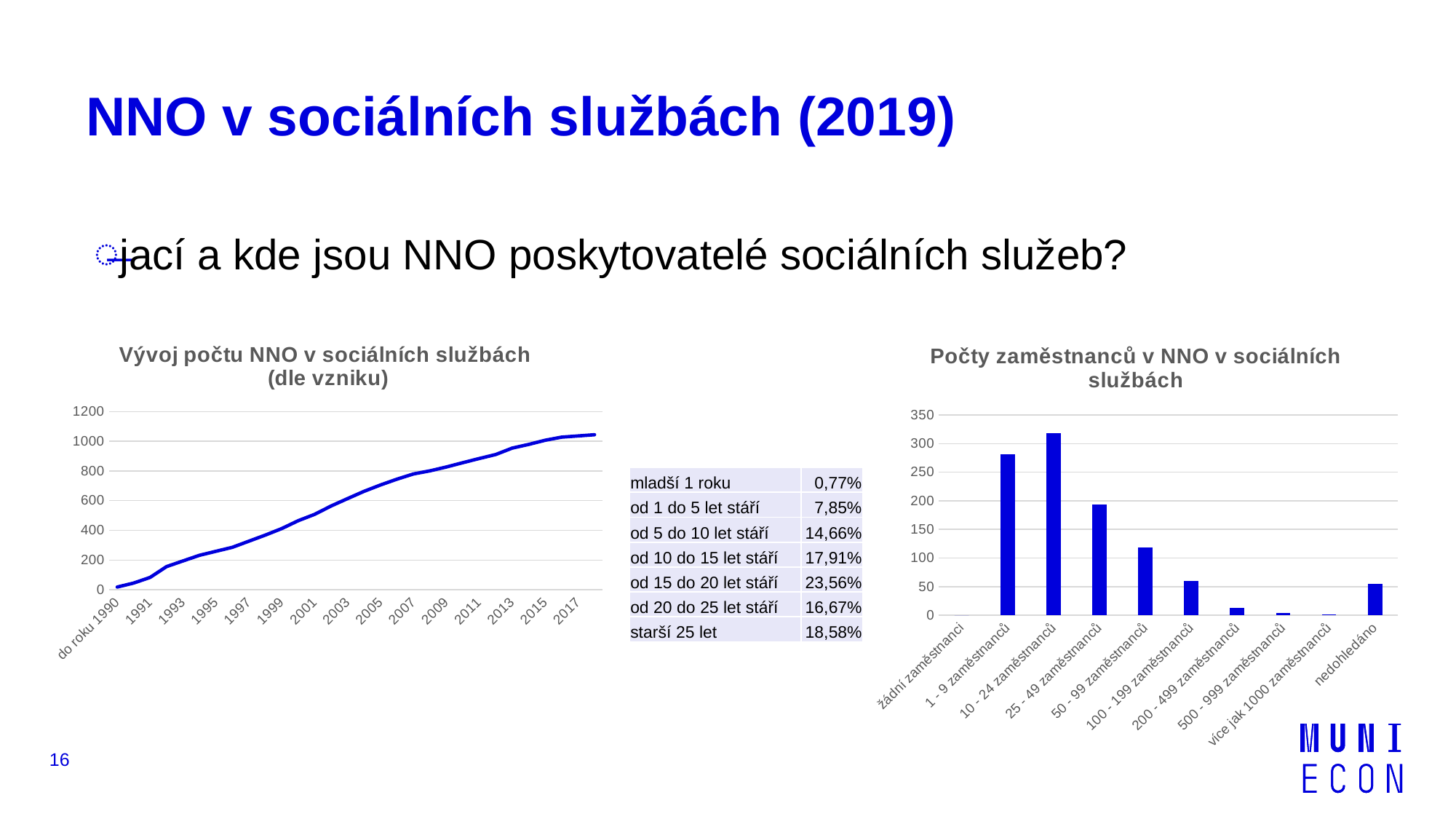
In the chart "Vývoj počtu NNO v sociálních službách (dle vzniku)", do the values rise or fall from 1990 to 2017? rise What kind of chart is "Vývoj počtu NNO v sociálních službách (dle vzniku)"? line chart In the chart "Vývoj počtu NNO v sociálních službách (dle vzniku)", is the value for 2017 greater or less than 1000? greater In the chart "Počty zaměstnanců v NNO v sociálních službách", is the value for 200 - 499 zaměstnanců greater or less than 50? less In the chart "Počty zaměstnanců v NNO v sociálních službách", which is larger: the value for 1 - 9 zaměstnanců or the value for 25 - 49 zaměstnanců? 1 - 9 zaměstnanců In the chart "Počty zaměstnanců v NNO v sociálních službách", which category has the highest value? 10 - 24 zaměstnanců What kind of chart is "Počty zaměstnanců v NNO v sociálních službách"? bar chart How many categories are shown on the x axis of the chart "Počty zaměstnanců v NNO v sociálních službách"? 10 In the chart "Počty zaměstnanců v NNO v sociálních službách", is the value for 10 - 24 zaměstnanců greater or less than 300? greater